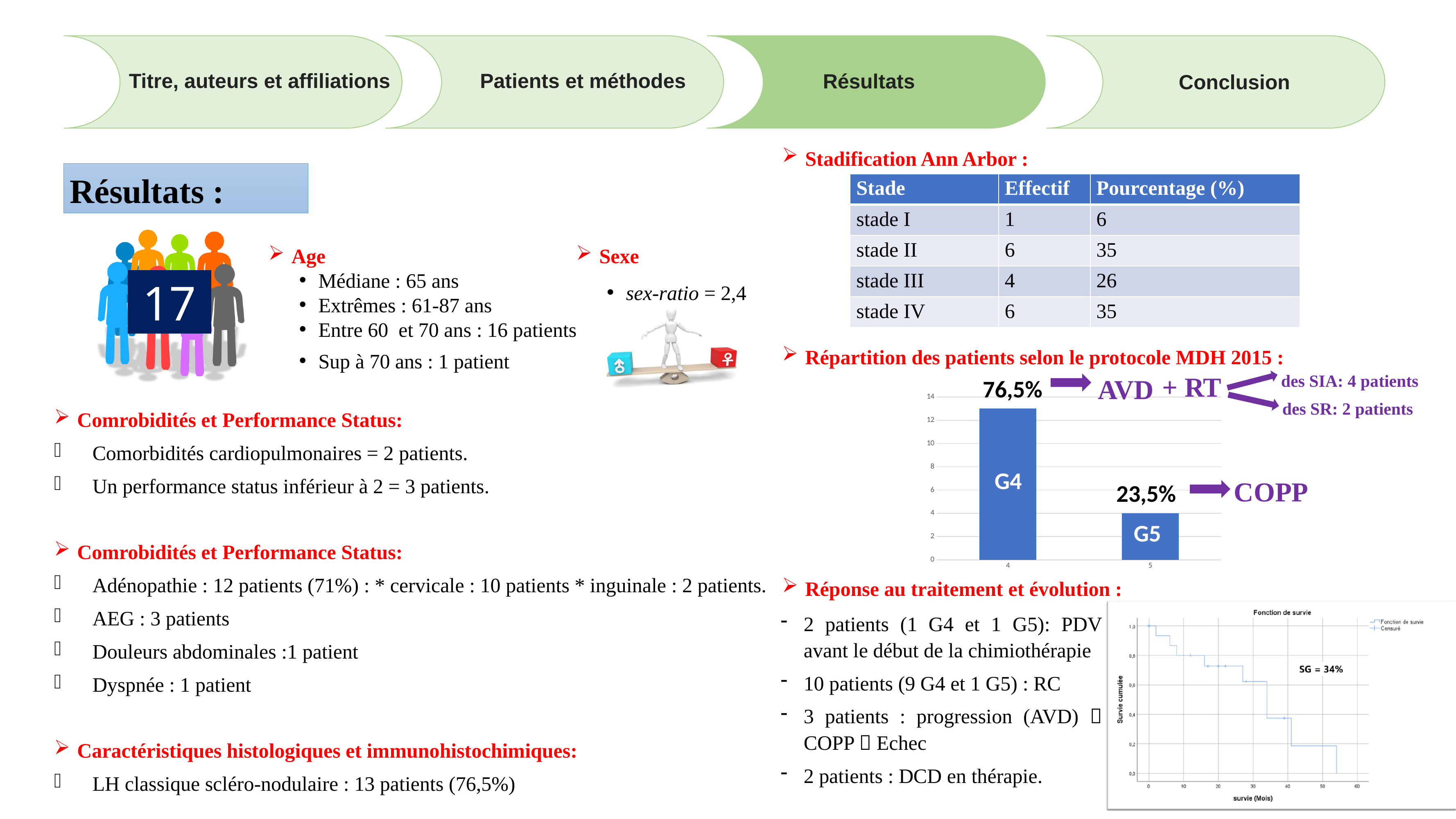
On the bar chart under 'Répartition des patients selon le protocole MDH 2015', what is the difference in percentage points between G4 and G5? 53 percentage points On the bar chart under 'Répartition des patients selon le protocole MDH 2015', which treatment does the G5 bar point to? COPP On the bar chart under 'Répartition des patients selon le protocole MDH 2015', what percentage is shown for G5? 23,5% What kind of chart is shown under 'Répartition des patients selon le protocole MDH 2015'? Bar chart On the survival chart at the bottom right ('Fonction de survie'), what value of SG is printed? SG = 34% On the bar chart under 'Répartition des patients selon le protocole MDH 2015', which group has the lower bar? G5 On the bar chart under 'Répartition des patients selon le protocole MDH 2015', what is the maximum value shown on the vertical axis? 14 On the bar chart under 'Répartition des patients selon le protocole MDH 2015', how many bars are plotted? 2 On the bar chart under 'Répartition des patients selon le protocole MDH 2015', is the bar for G4 greater or less than 12 on the vertical axis? greater On the bar chart under 'Répartition des patients selon le protocole MDH 2015', is the bar for G5 greater or less than 6 on the vertical axis? less On the bar chart under 'Répartition des patients selon le protocole MDH 2015', which group has the higher bar? G4 On the bar chart under 'Répartition des patients selon le protocole MDH 2015', what percentage is shown for G4? 76,5%